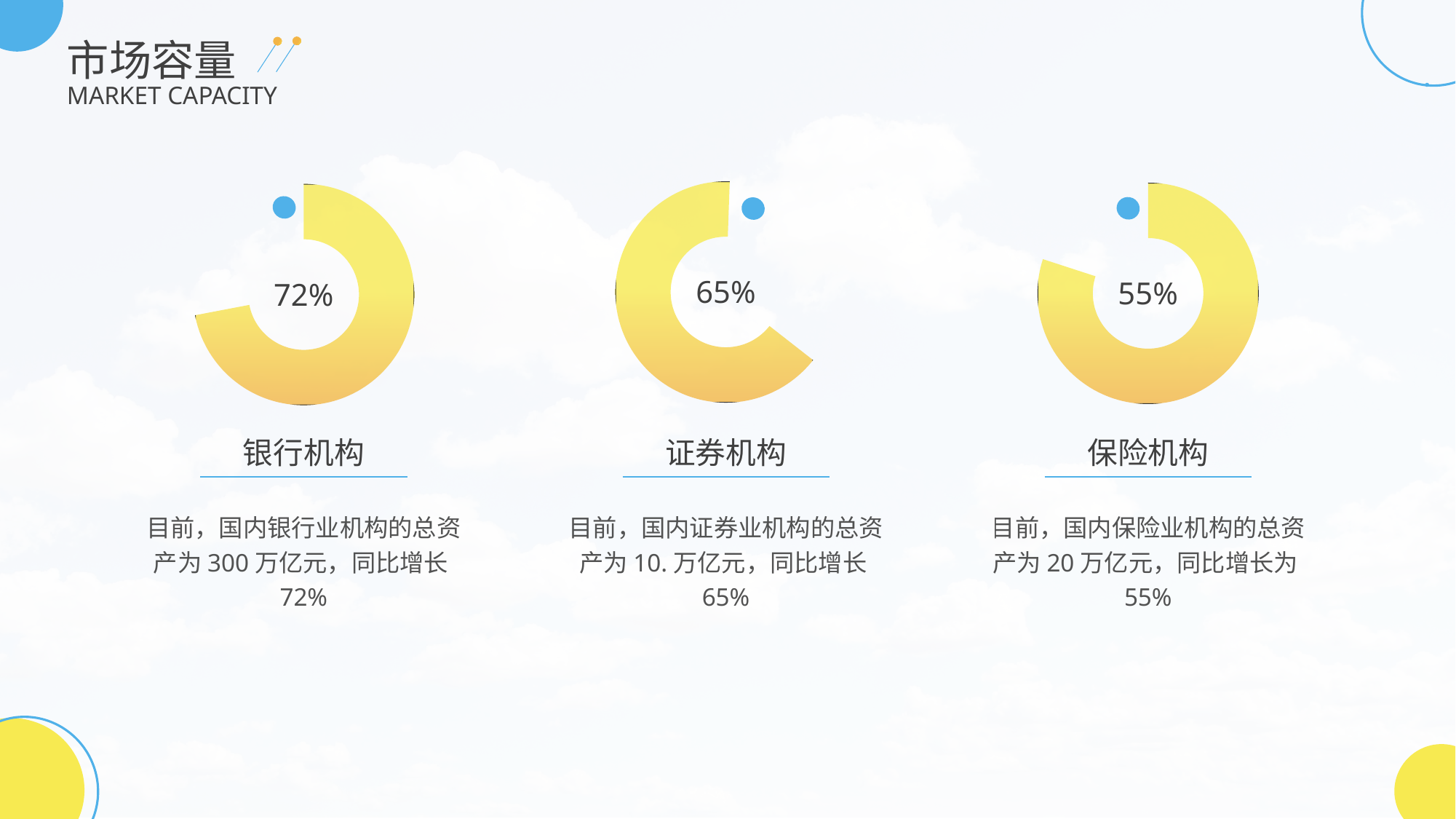
Which of the three donut charts shows the lowest percentage? 保险机构 Do the percentages in the three donut charts rise or fall from left to right across the slide? Fall What percentage is shown in the centre of the 银行机构 donut chart on the left? 72% How many donut charts are on the slide? 3 What percentage is shown in the centre of the 证券机构 donut chart in the middle? 65% What kind of chart is used for each of the three institution types on the slide? Donut chart What is the difference between the percentage in the 银行机构 chart and the percentage in the 保险机构 chart? 17% What percentage is shown in the centre of the 保险机构 donut chart on the right? 55% What colour is the filled ring in each of the three donut charts? Yellow What is the difference between the percentage in the 证券机构 chart and the percentage in the 保险机构 chart? 10% Which shows a larger percentage, the 银行机构 chart or the 证券机构 chart? 银行机构 Which of the three donut charts shows the highest percentage? 银行机构